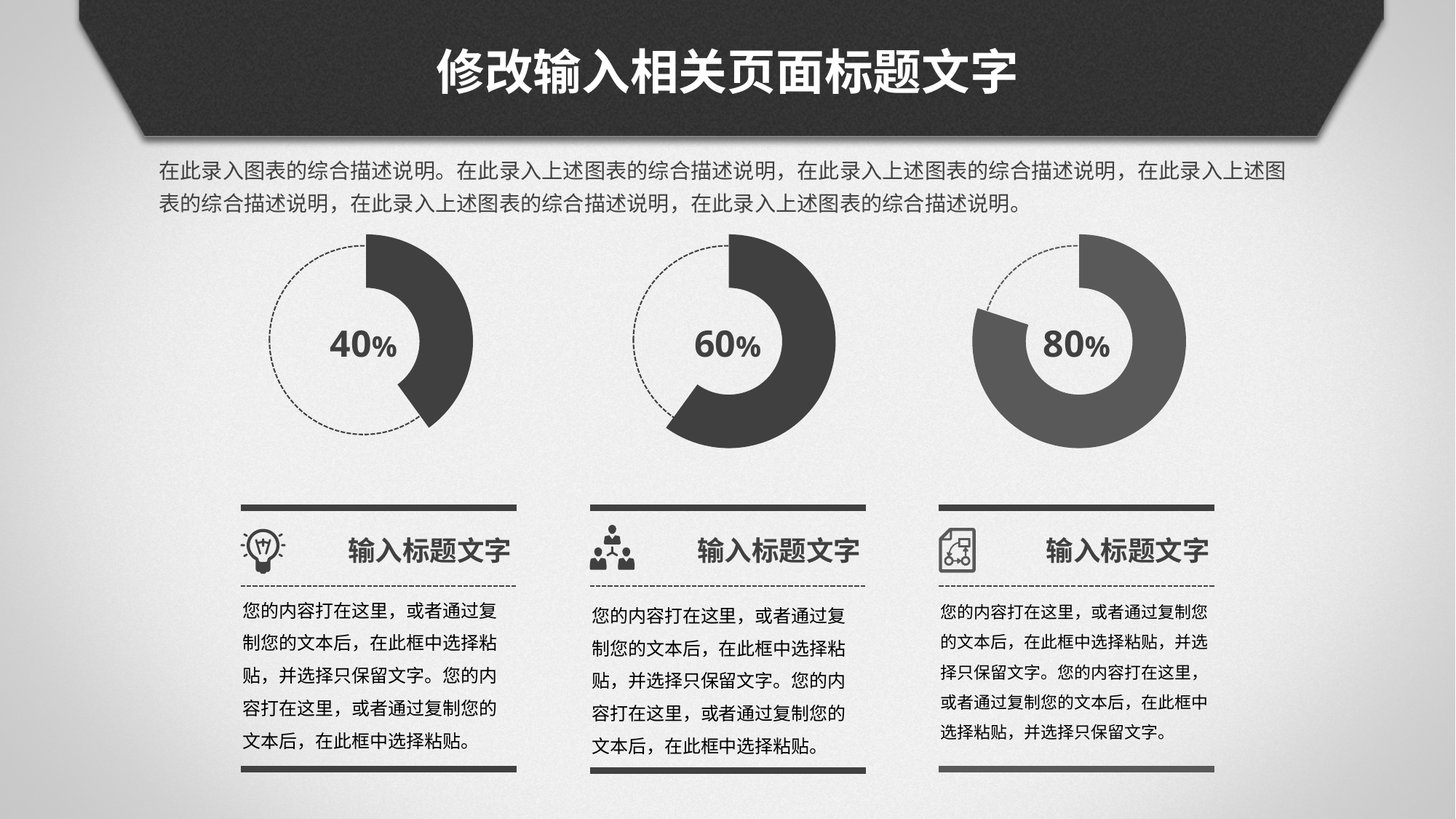
How many donut charts are on the slide? 3 Do the values in the donut charts increase or decrease from left to right across the slide? increase Which of the three donut charts shows the lowest value: left, middle or right? left What is the difference between the value in the middle donut chart and the value in the left donut chart? 20% What colour is the filled portion of each donut chart? dark grey What value is shown in the right donut chart? 80% What kind of chart is used to display the percentages on the slide? donut chart Which is larger, the value in the middle donut chart or the value in the left donut chart? middle Which of the three donut charts shows the highest value: left, middle or right? right What value is shown in the middle donut chart? 60% What value is shown in the left donut chart? 40% What is the difference between the value in the right donut chart and the value in the left donut chart? 40%